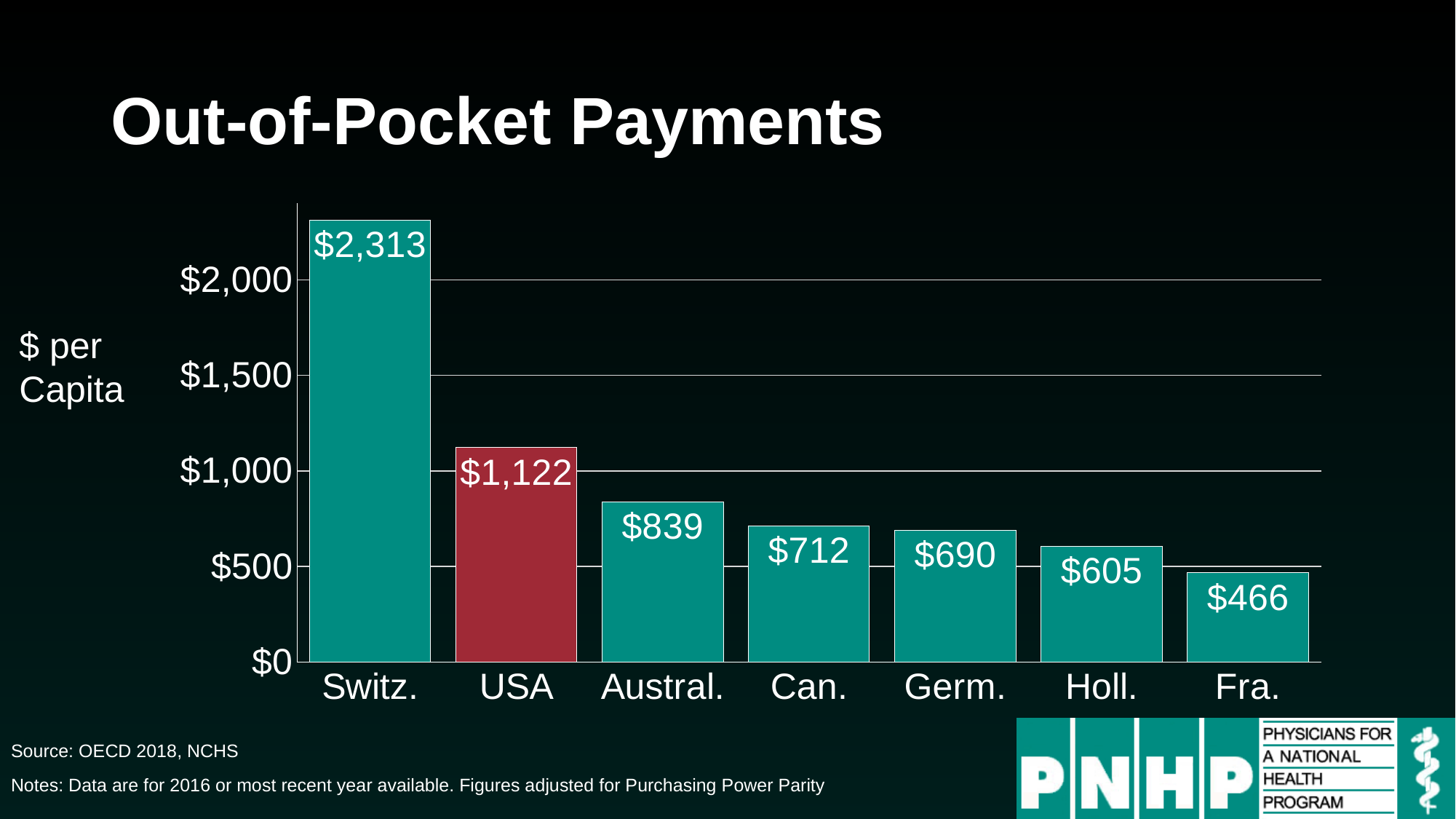
Which country has the highest out-of-pocket payments? Switz. What is the out-of-pocket payment value for Germ.? $690 What kind of chart is shown on the slide? bar chart What is the out-of-pocket payment value for the USA? $1,122 What is the difference between the values for Austral. and Can.? $127 What is the difference between the values for Switz. and the USA? $1,191 How many countries are shown in the chart? 7 Do the values rise or fall from left to right across the chart? fall Which country has the lowest out-of-pocket payments? Fra. Which has a larger value, Holl. or Fra.? Holl. Which bar is shown in a different colour (red) from the others? USA Is the value for Austral. greater or less than $1,000? less